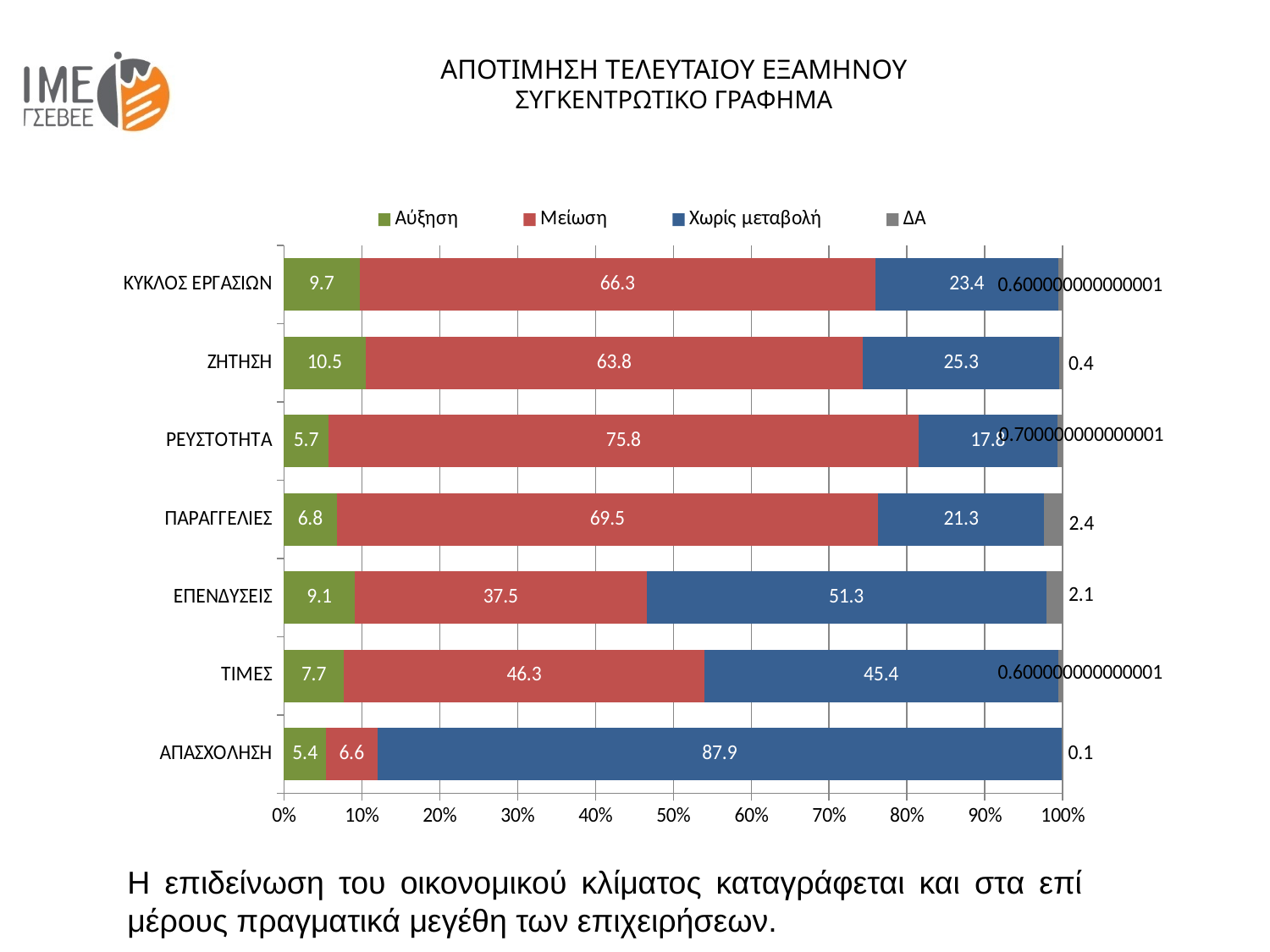
Which category has the lowest Μείωση value? ΑΠΑΣΧΟΛΗΣΗ What kind of chart is shown on the slide? Stacked bar chart How many series does the legend list? 4 What is the value of ΔΑ for ΠΑΡΑΓΓΕΛΙΕΣ? 2.4 What is the value of Χωρίς μεταβολή for ΑΠΑΣΧΟΛΗΣΗ? 87.9 Which category has the highest Αύξηση value? ΖΗΤΗΣΗ What is the value of Αύξηση for ΖΗΤΗΣΗ? 10.5 How many categories are shown on the chart? 7 Which category has the highest Μείωση value? ΡΕΥΣΤΟΤΗΤΑ What is the value of Μείωση for ΡΕΥΣΤΟΤΗΤΑ? 75.8 For ΕΠΕΝΔΥΣΕΙΣ, which is larger: Μείωση or Χωρίς μεταβολή? Χωρίς μεταβολή What is the difference between the Μείωση values for ΚΥΚΛΟΣ ΕΡΓΑΣΙΩΝ and ΖΗΤΗΣΗ? 2.5